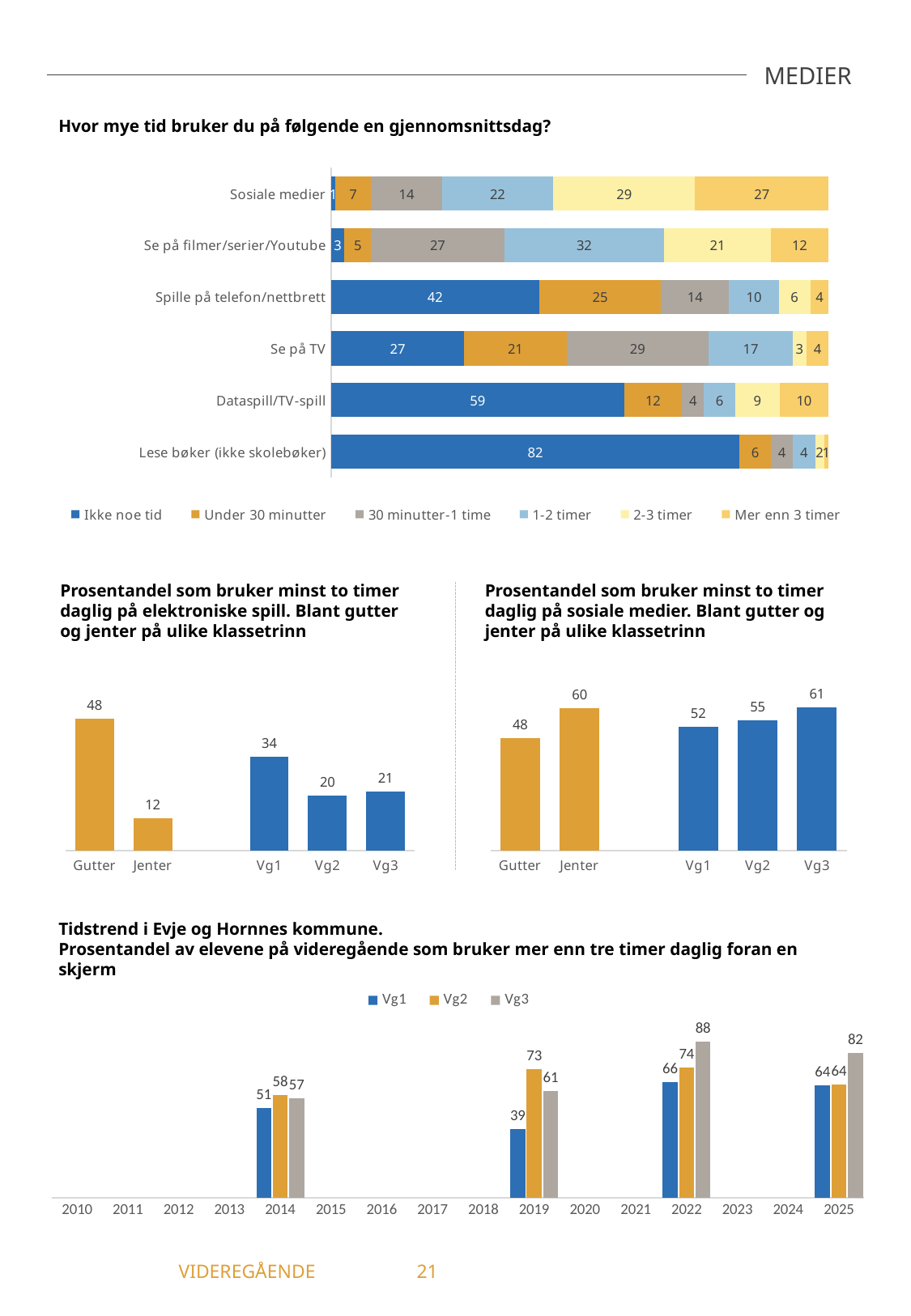
In the chart 'Prosentandel som bruker minst to timer daglig på elektroniske spill', what is the value for Jenter? 12 In the chart 'Prosentandel som bruker minst to timer daglig på elektroniske spill', what is the difference between the values for Gutter and Jenter? 36 In the chart 'Prosentandel som bruker minst to timer daglig på sosiale medier', which category has the lowest value? Gutter In the bottom chart 'Tidstrend i Evje og Hornnes kommune', does the Vg3 value rise or fall from 2014 to 2022? Rise In the top chart 'Hvor mye tid bruker du på følgende en gjennomsnittsdag?', what is the value for 'Ikke noe tid' in the 'Lese bøker (ikke skolebøker)' bar? 82 What kind of chart is the bottom chart 'Tidstrend i Evje og Hornnes kommune'? Bar chart How many categories (bars) are shown in the top chart 'Hvor mye tid bruker du på følgende en gjennomsnittsdag?'? 6 In the top chart 'Hvor mye tid bruker du på følgende en gjennomsnittsdag?', what is the value for '2-3 timer' in the 'Sosiale medier' bar? 29 In the chart 'Prosentandel som bruker minst to timer daglig på sosiale medier', which is larger, the value for Gutter or for Jenter? Jenter In the bottom chart 'Tidstrend i Evje og Hornnes kommune', what is the difference between the Vg2 and Vg1 values in 2019? 34 In the bottom chart 'Tidstrend i Evje og Hornnes kommune', what is the value for Vg3 in 2022? 88 How many series does the legend of the top chart 'Hvor mye tid bruker du på følgende en gjennomsnittsdag?' list? 6